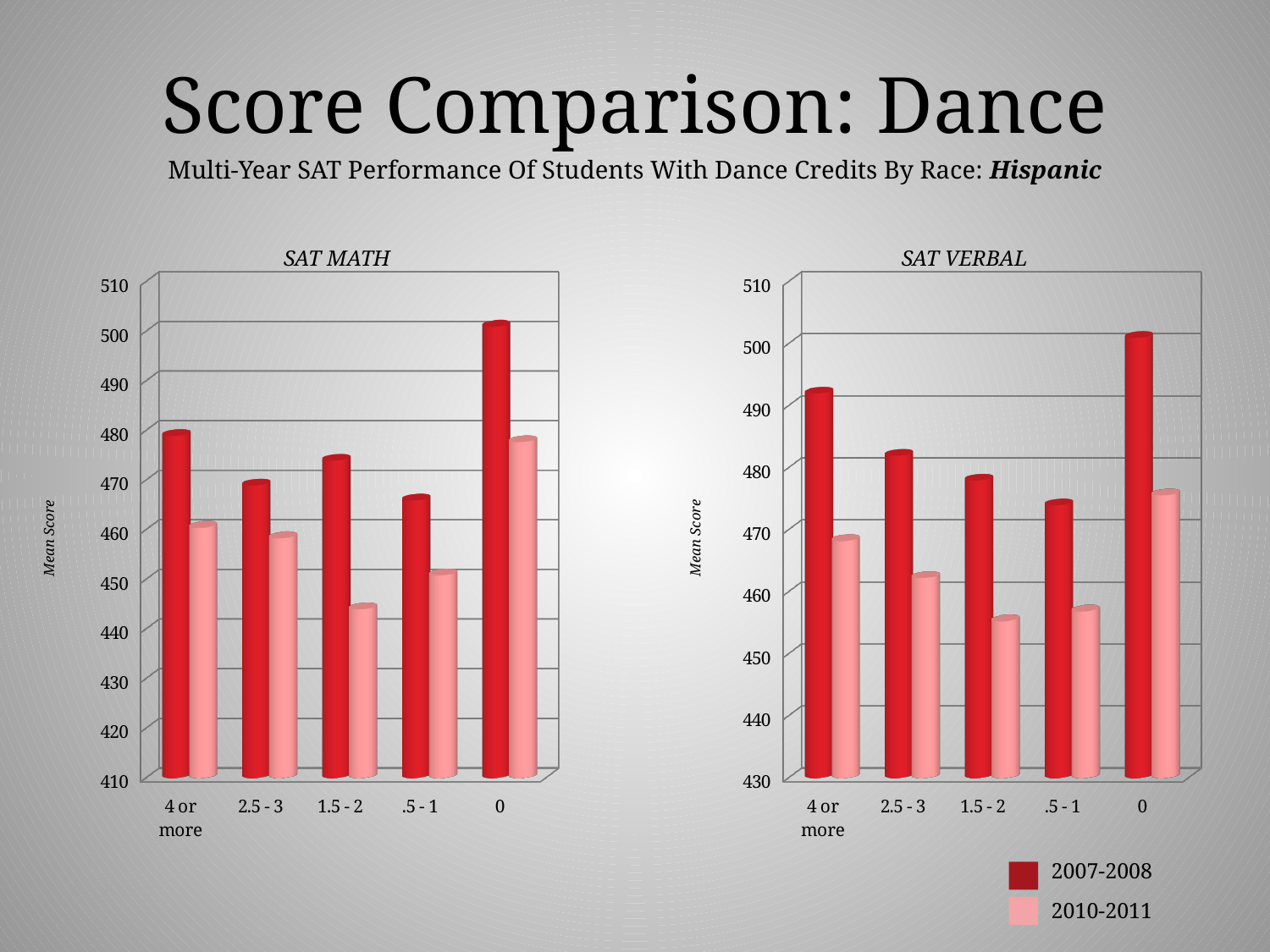
In the SAT VERBAL chart, is the 2007-2008 value for the 4 or more category greater or less than 480? greater In the SAT MATH chart, is the 2010-2011 value for the 1.5 - 2 category greater or less than 450? less In the SAT VERBAL chart, which category has the lowest 2007-2008 score? .5 - 1 What kind of chart is the SAT MATH chart? bar chart In the SAT MATH chart, which category has the lowest 2010-2011 score? 1.5 - 2 In the SAT VERBAL chart, which series has the larger value for the 4 or more category, 2007-2008 or 2010-2011? 2007-2008 How many credit categories are shown on the x axis of the SAT VERBAL chart? 5 How many series does the legend list? 2 In the SAT MATH chart, is the 2007-2008 value for the 0 category greater or less than 490? greater In the SAT VERBAL chart, which category has the highest 2010-2011 score? 0 What is the label on the vertical axis of the SAT MATH chart? Mean Score In the SAT MATH chart, which category has the highest 2007-2008 score? 0